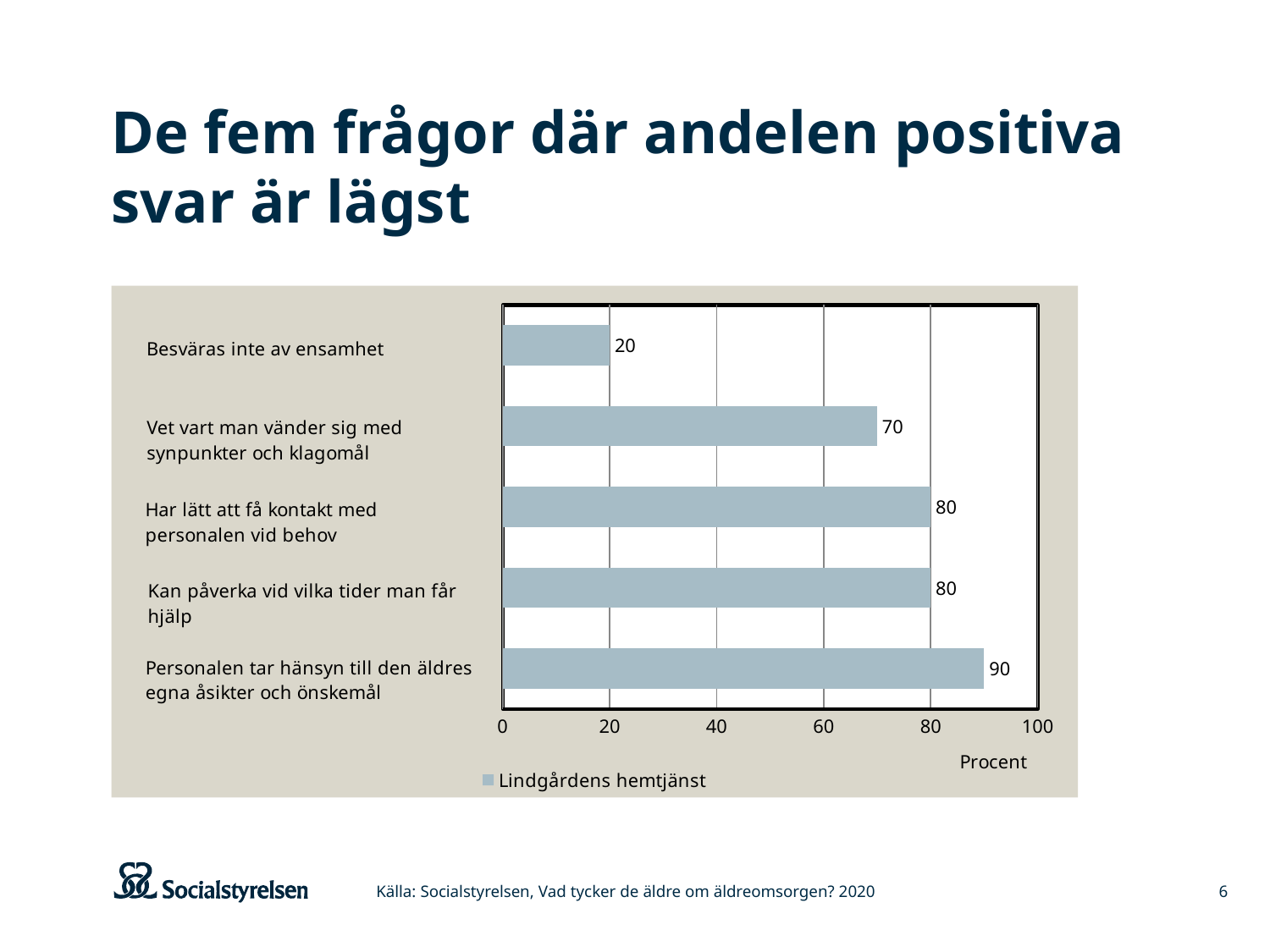
What is the value for "Besväras inte av ensamhet"? 20 What is the value for "Har lätt att få kontakt med personalen vid behov"? 80 What is the series name shown in the legend? Lindgårdens hemtjänst Which is larger: the value for "Vet vart man vänder sig med synpunkter och klagomål" or the value for "Kan påverka vid vilka tider man får hjälp"? Kan påverka vid vilka tider man får hjälp Which category has the lowest value? Besväras inte av ensamhet How many series does the legend list? 1 What is the difference between the values for "Personalen tar hänsyn till den äldres egna åsikter och önskemål" and "Besväras inte av ensamhet"? 70 What is the value for "Personalen tar hänsyn till den äldres egna åsikter och önskemål"? 90 How many categories are shown in the chart? 5 What is the value for "Vet vart man vänder sig med synpunkter och klagomål"? 70 What kind of chart is shown on the slide? Bar chart Which category has the highest value? Personalen tar hänsyn till den äldres egna åsikter och önskemål